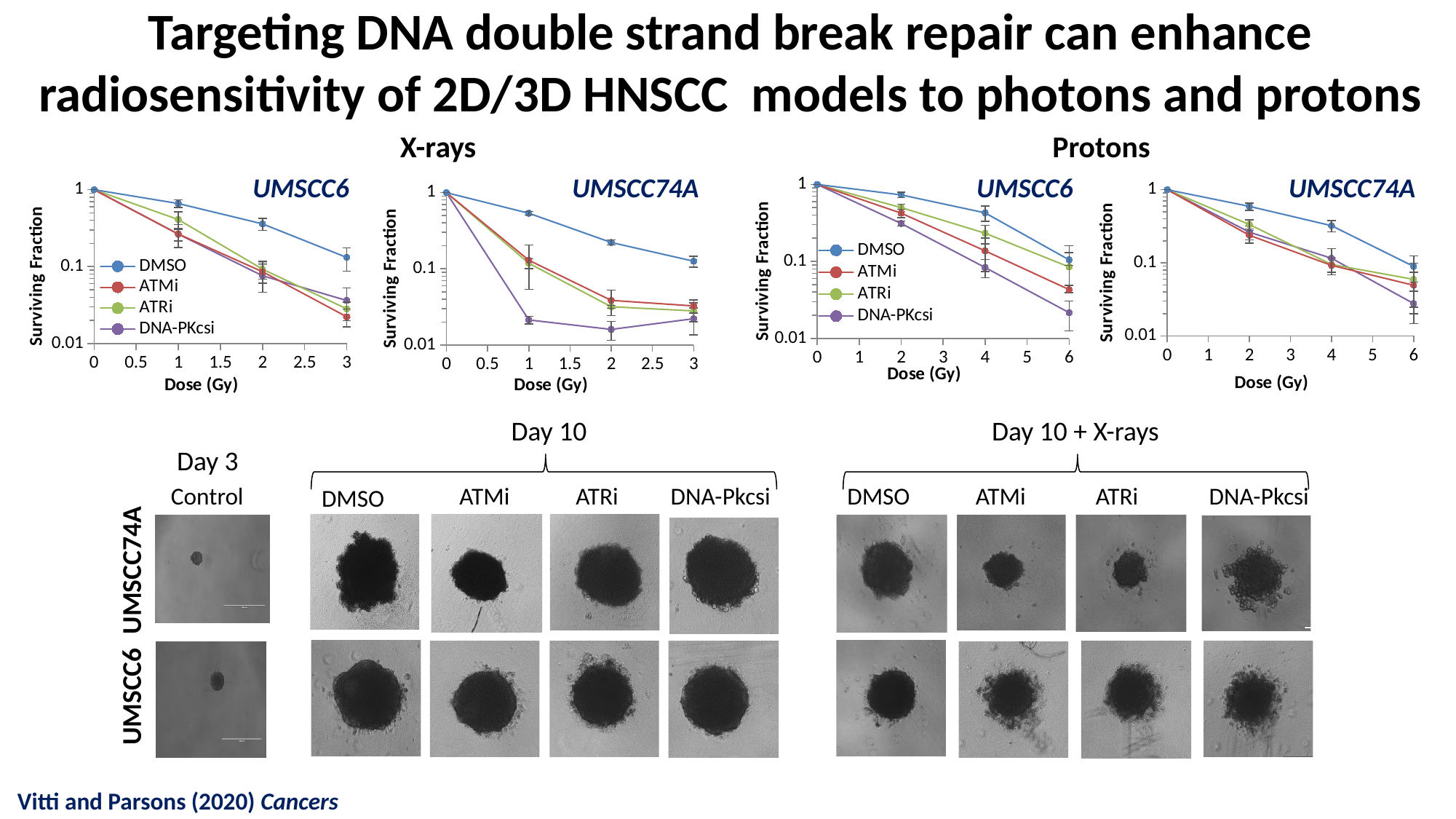
What is the label of the x axis on the Protons UMSCC74A chart? Dose (Gy) In the Protons UMSCC6 chart, is the surviving fraction for DMSO at 2 Gy greater or less than 0.1? greater In the X-rays UMSCC74A chart, which series has the lowest surviving fraction at 1 Gy? DNA-PKcsi What kind of chart is the X-rays UMSCC6 chart? line chart How many series does the legend of the X-rays UMSCC6 chart list? 4 In the X-rays UMSCC6 chart, what is the surviving fraction for DMSO at 0 Gy? 1 In the X-rays UMSCC74A chart, is the surviving fraction for DNA-PKcsi at 2 Gy greater or less than 0.1? less In the Protons UMSCC74A chart, does the surviving fraction for DMSO rise or fall as dose increases? fall In the Protons UMSCC6 chart, which series has the lowest surviving fraction at 6 Gy? DNA-PKcsi In the X-rays UMSCC6 chart, which series has the highest surviving fraction at 3 Gy? DMSO In the Protons UMSCC74A chart, which is larger at 6 Gy: the surviving fraction for DMSO or for DNA-PKcsi? DMSO How many dose points are plotted for each series in the Protons UMSCC6 chart? 4